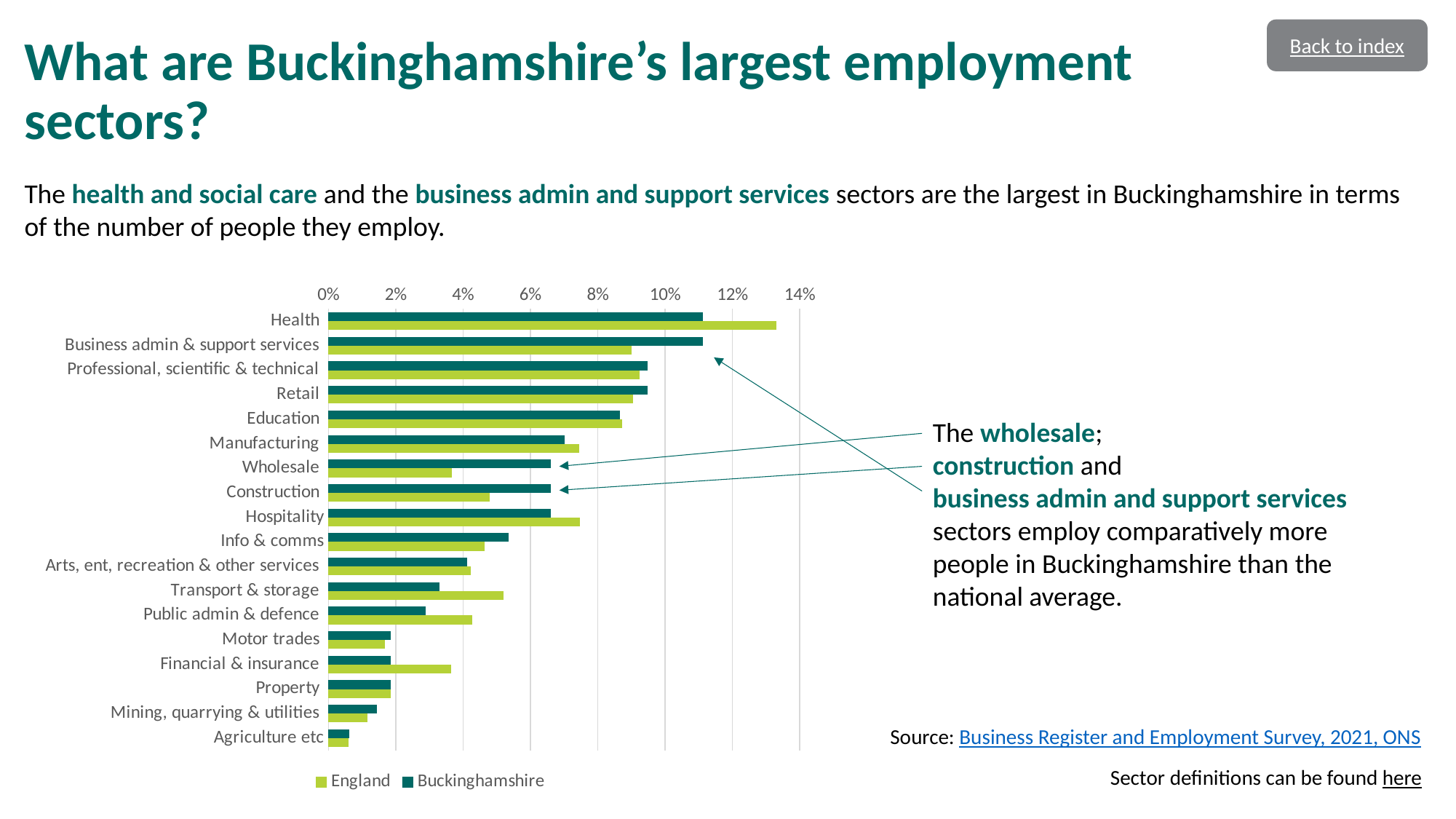
How many sectors are plotted on the chart? 18 What kind of chart is shown on the slide? bar chart For Wholesale, which is larger: the England value or the Buckinghamshire value? Buckinghamshire Which series is shown in light green in the chart legend? England Is the England value for Health greater or less than 12%? greater Is the England value for Wholesale greater or less than 4%? less Is the Buckinghamshire value for Construction greater or less than 6%? greater Which sector has the highest value for England? Health How many series does the chart legend list? 2 Which sector has the lowest value for Buckinghamshire? Agriculture etc For Hospitality, which is larger: the England value or the Buckinghamshire value? England